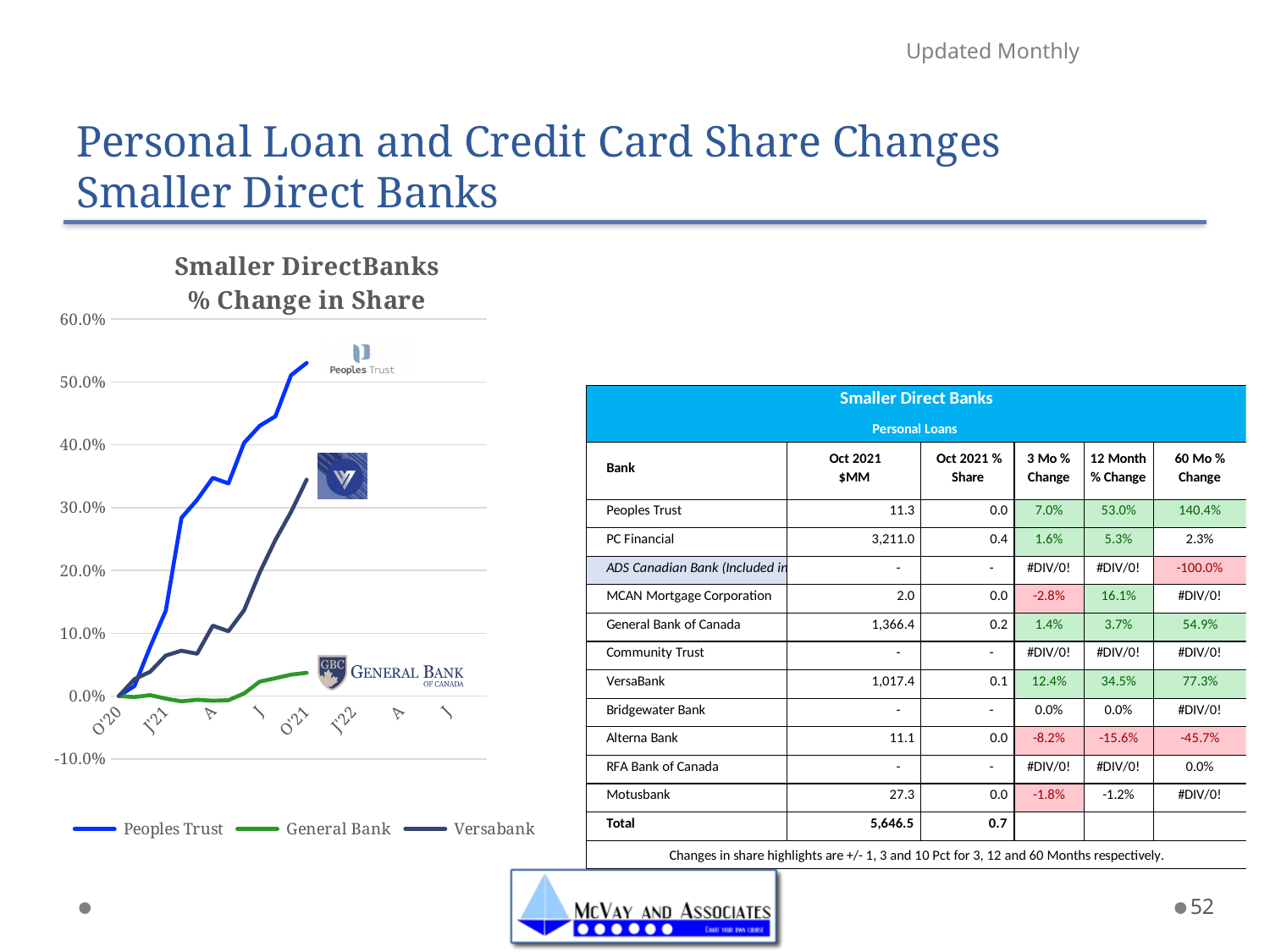
What kind of chart is shown on the slide? line chart How many series does the legend of the chart list? 3 Is the final value for Versabank greater or less than 30.0%? greater What is the title of the chart? Smaller DirectBanks % Change in Share Is the final value for General Bank greater or less than 10.0%? less Which series are listed in the chart's legend? Peoples Trust, General Bank, Versabank Which series has the lowest value at the end of the plotted period? General Bank Is the final value for Peoples Trust greater or less than 50.0%? greater At the end of the plotted period, which is larger: the value for Versabank or the value for General Bank? Versabank Does the Peoples Trust line generally rise or fall along the x axis? rise How many labels are shown on the x axis of the chart? 8 Which series has the highest value at the end of the plotted period? Peoples Trust